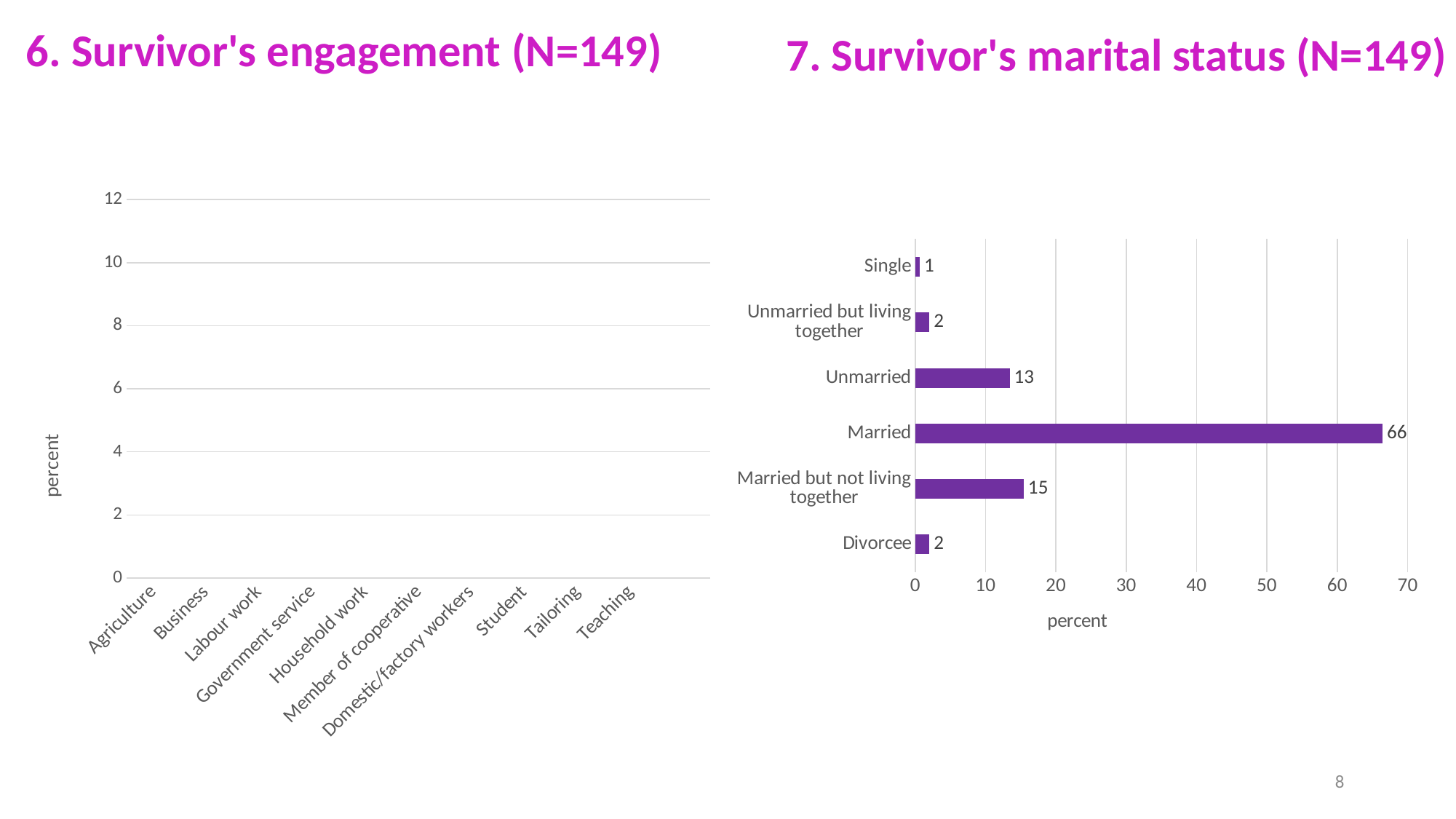
In the chart titled "7. Survivor's marital status (N=149)", what is the difference between the values for Married and Married but not living together? 51 In the chart titled "7. Survivor's marital status (N=149)", what is the value for Married but not living together? 15 What kind of chart is the chart titled "7. Survivor's marital status (N=149)"? Bar chart In the chart titled "7. Survivor's marital status (N=149)", what is the label on the horizontal axis? percent In the chart titled "7. Survivor's marital status (N=149)", how many categories are shown? 6 In the chart titled "7. Survivor's marital status (N=149)", what is the value for Unmarried? 13 In the chart titled "7. Survivor's marital status (N=149)", which category has the lowest value? Single In the chart titled "7. Survivor's marital status (N=149)", what is the value for Married? 66 In the chart titled "7. Survivor's marital status (N=149)", which is larger, the value for Unmarried or the value for Married but not living together? Married but not living together In the chart titled "7. Survivor's marital status (N=149)", what is the value for Single? 1 In the chart titled "7. Survivor's marital status (N=149)", which category has the highest value? Married In the chart titled "6. Survivor's engagement (N=149)", how many categories are listed on the horizontal axis? 10